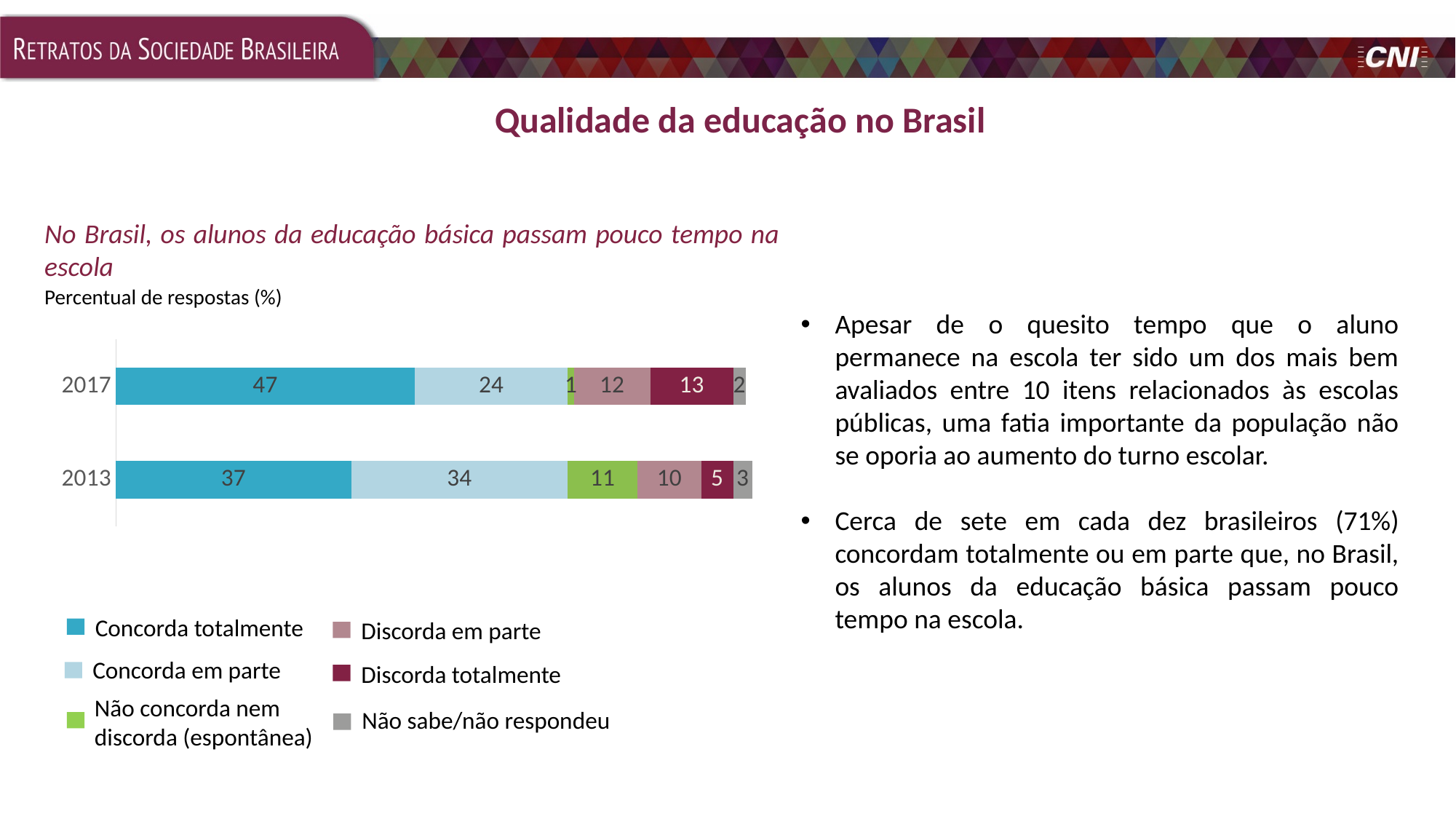
What is the value for "Não concorda nem discorda (espontânea)" in 2013? 11 Which legend entry is represented by the green colour? Não concorda nem discorda (espontânea) How many years (categories) are shown in the chart? 2 What is the total of the stacked bar for 2013? 100 By how many percentage points did "Concorda totalmente" change from 2013 to 2017? 10 What is the difference between "Discorda totalmente" in 2017 and in 2013? 8 How many series does the legend list? 6 What kind of chart is shown on the slide? Stacked bar chart What is the value for "Discorda totalmente" in 2017? 13 Which year has the higher value for "Concorda totalmente"? 2017 What percentage of respondents answered "Concorda em parte" in 2013? 34 What percentage of respondents answered "Concorda totalmente" in 2017? 47